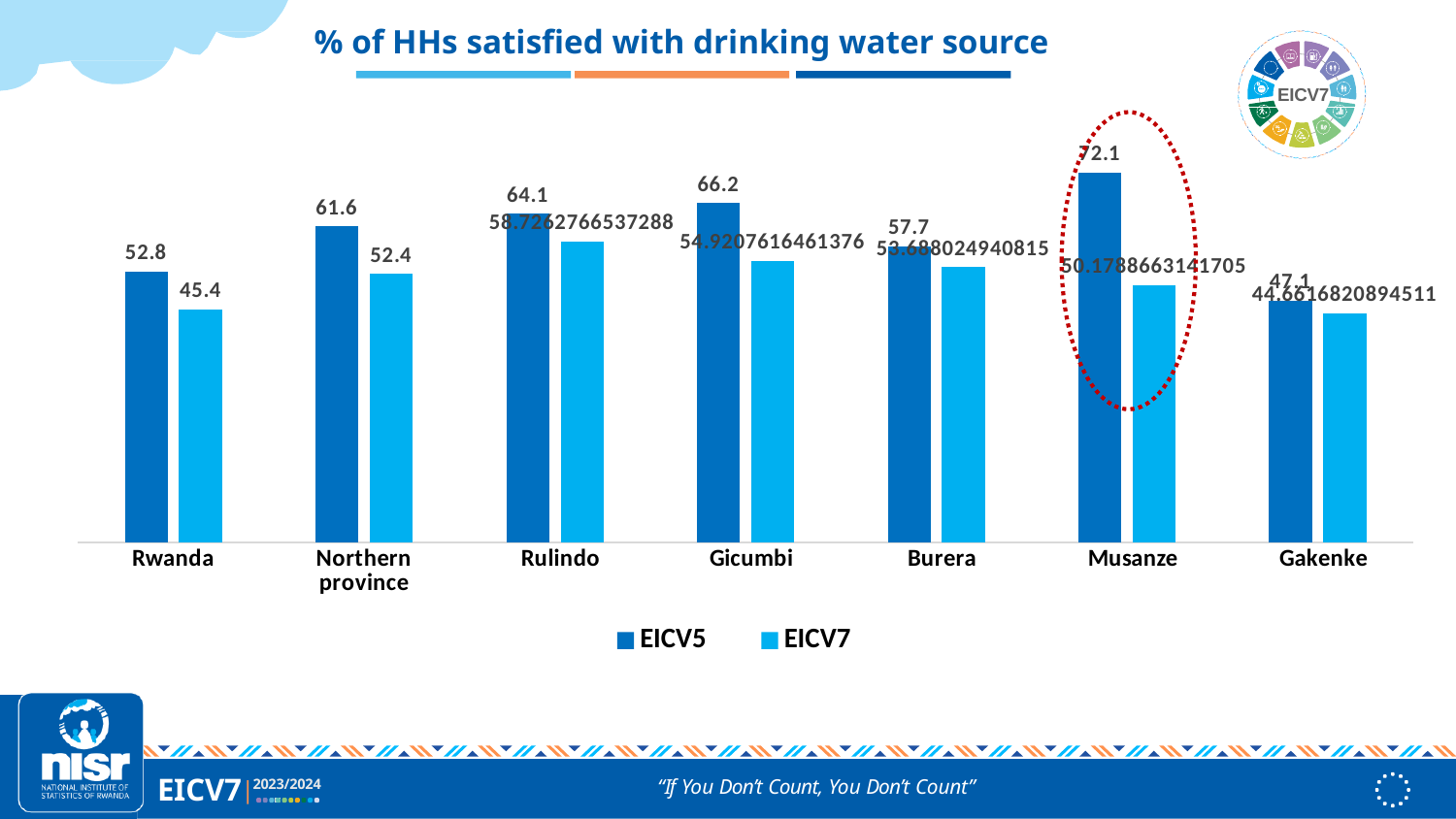
What is the EICV5 value for Northern province? 61.6 What is the EICV7 value for Northern province? 52.4 Which category has the lowest EICV5 value? Gakenke What is the EICV7 value for Rwanda? 45.4 Which category has the highest EICV7 value? Rulindo How many categories are shown on the x axis? 7 Which is larger, the EICV5 value for Gicumbi or the EICV5 value for Rulindo? Gicumbi How many series does the legend list? 2 What is the difference between the EICV5 and EICV7 values for Rwanda? 7.4 Which category is highlighted with a red dotted circle? Musanze Which category has the highest EICV5 value? Musanze What is the EICV5 value for Musanze? 72.1